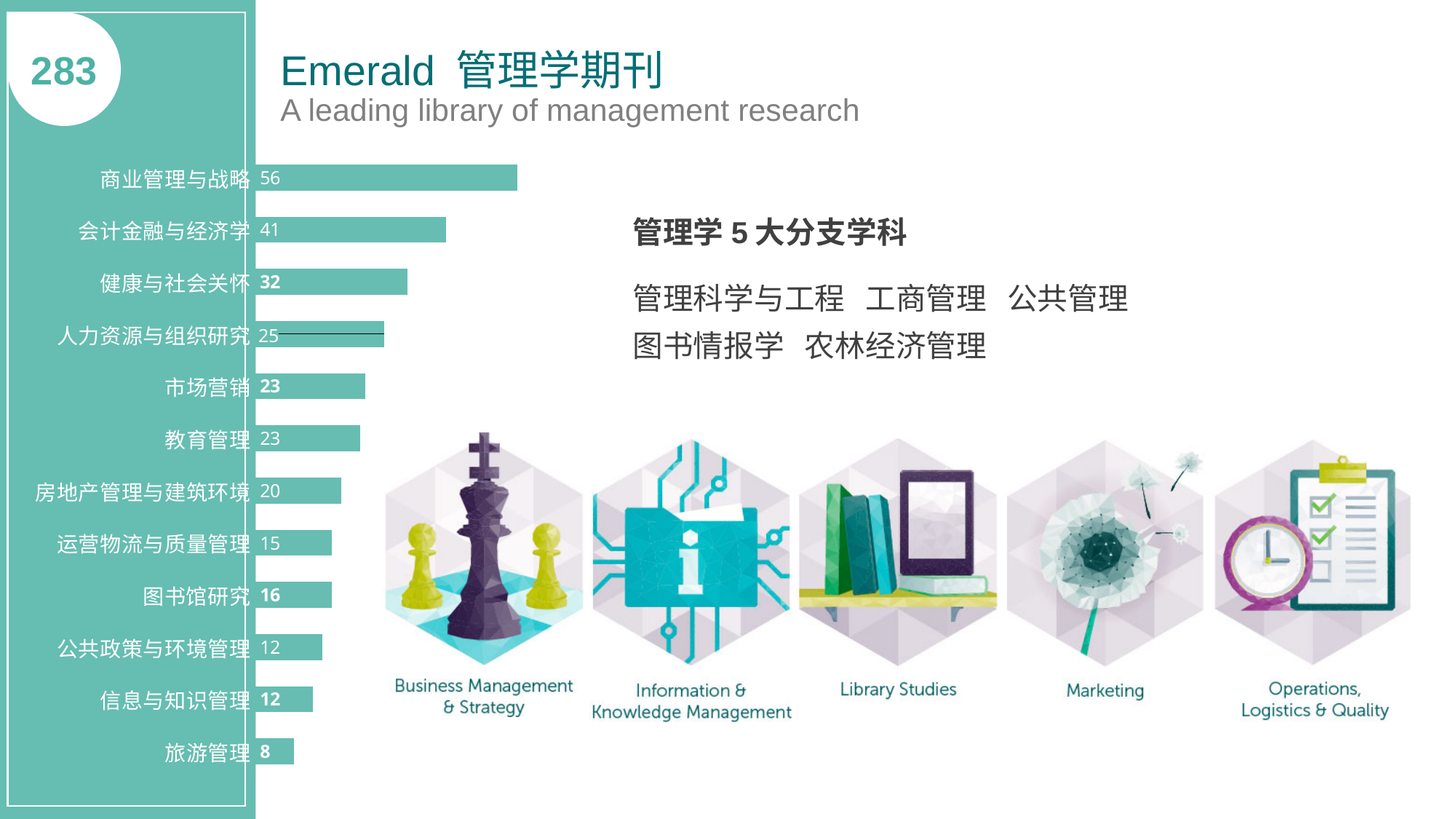
What is the value for 房地产管理与建筑环境? 20 What is the difference between the values for 商业管理与战略 and 会计金融与经济学? 15 What is the difference between the values for 健康与社会关怀 and 旅游管理? 24 How many categories does the bar chart show? 12 Which category has the highest value in the bar chart? 商业管理与战略 What is the value for 健康与社会关怀? 32 What is the value for 会计金融与经济学? 41 What kind of chart is shown on the left of the slide? bar chart Which is larger, the value for 人力资源与组织研究 or the value for 市场营销? 人力资源与组织研究 Which category has the lowest value in the bar chart? 旅游管理 What is the value for 商业管理与战略? 56 What is the value for 旅游管理? 8